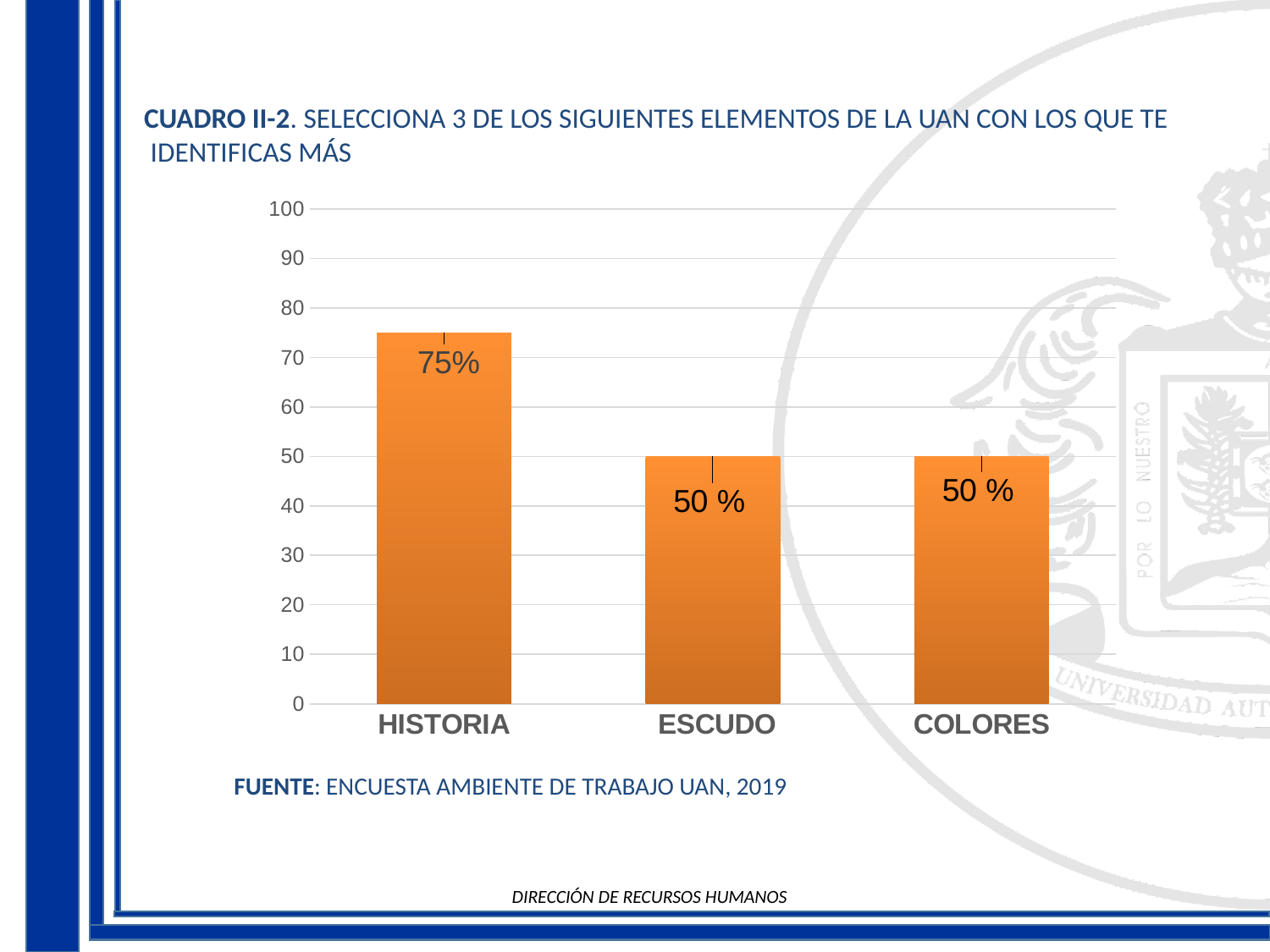
How many categories are shown on the x axis? 3 What kind of chart is shown on the slide? bar chart What is the source cited below the chart? ENCUESTA AMBIENTE DE TRABAJO UAN, 2019 Is the value for HISTORIA greater or less than 70? greater What is the difference between the values for HISTORIA and ESCUDO? 25 What is the value for HISTORIA? 75% What is the maximum value shown on the y axis? 100 What is the value for ESCUDO? 50 % What is the value for COLORES? 50 % Which is larger, the value for HISTORIA or the value for COLORES? HISTORIA Which category has the highest value? HISTORIA Is the value for ESCUDO greater or less than 60? less